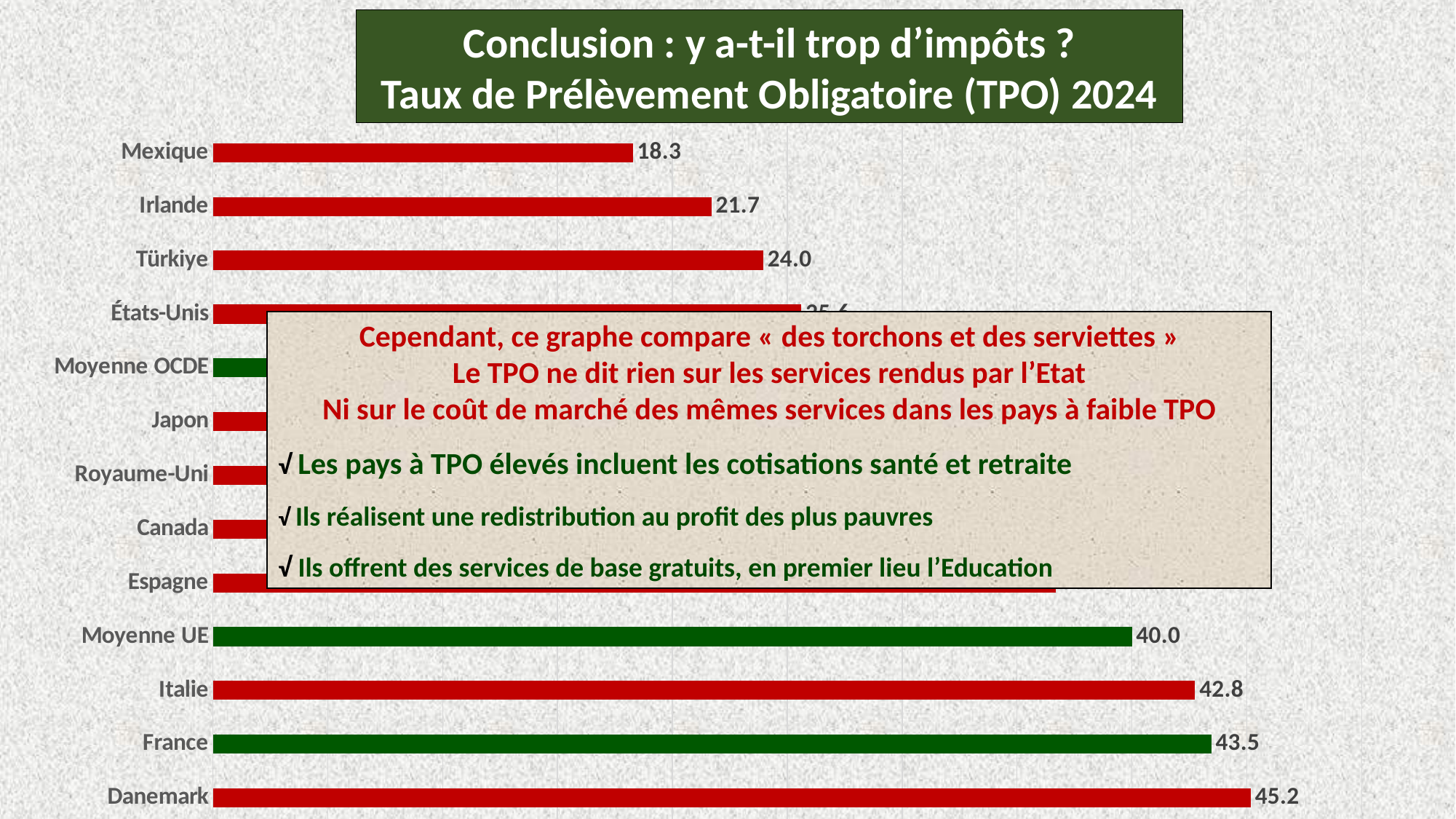
What is the value for Moyenne UE? 40.0 What is the value for Türkiye? 24.0 What is the value for Irlande? 21.7 Which category has the highest value? Danemark Which is larger, the value for Italie or the value for Moyenne UE? Italie What is the difference between the values for Danemark and Mexique? 26.9 Which category has the lowest value? Mexique What is the value for Italie? 42.8 What is the value for France? 43.5 What is the value for Mexique? 18.3 What is the value for Danemark? 45.2 How many categories are shown in the chart? 13